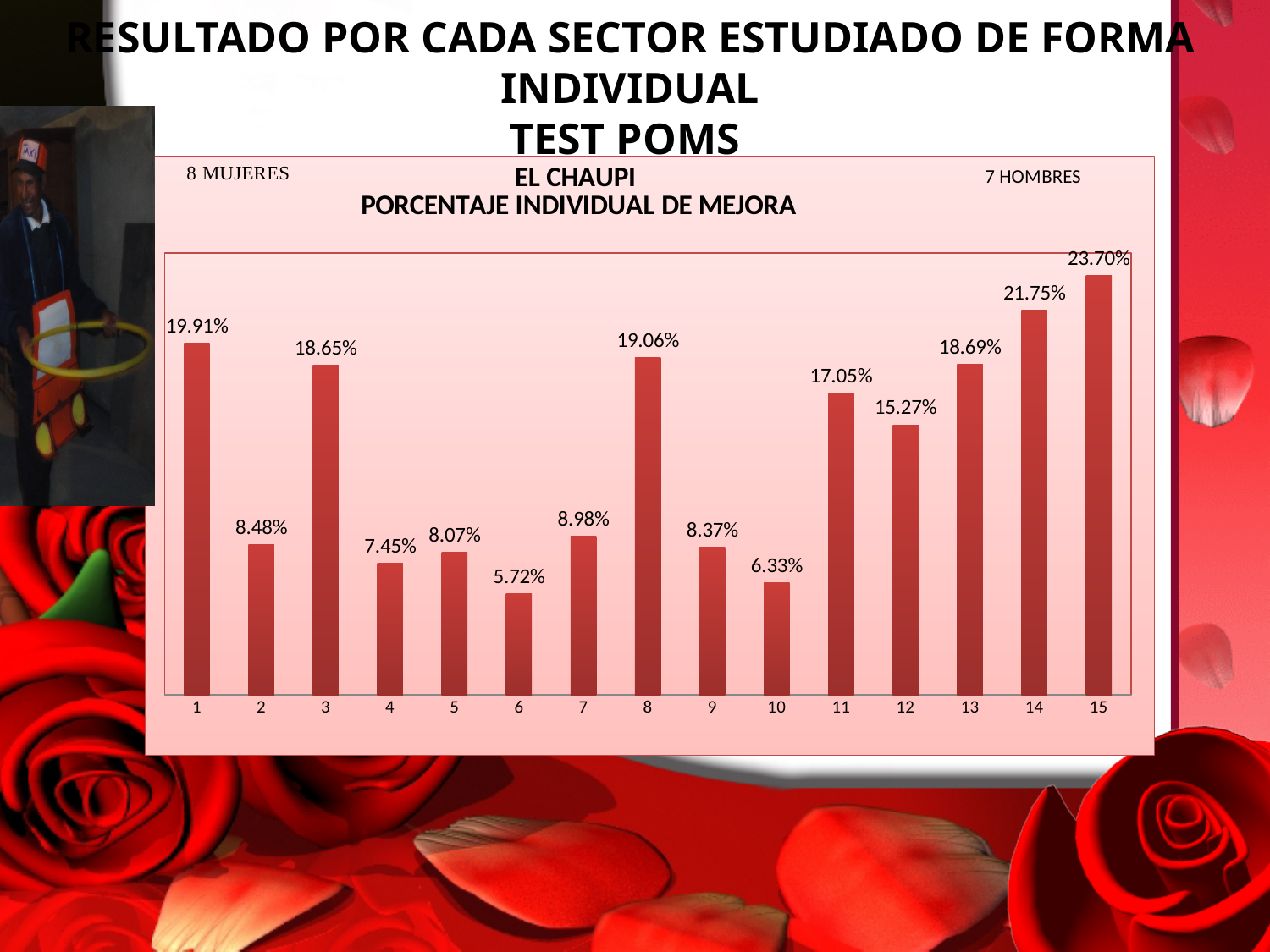
What is the difference between the values for category 15 and category 14? 1.95% What is the difference between the values for category 1 and category 2? 11.43% What is the value for category 1? 19.91% Which category has the lowest value? 6 What kind of chart is shown on the slide? bar chart What is the value for category 12? 15.27% Which is larger, the value for category 11 or the value for category 12? category 11 Which category has the highest value? 15 How many categories are shown on the x axis? 15 What is the title of the chart? EL CHAUPI PORCENTAJE INDIVIDUAL DE MEJORA Which is larger, the value for category 4 or the value for category 7? category 7 What is the value for category 6? 5.72%